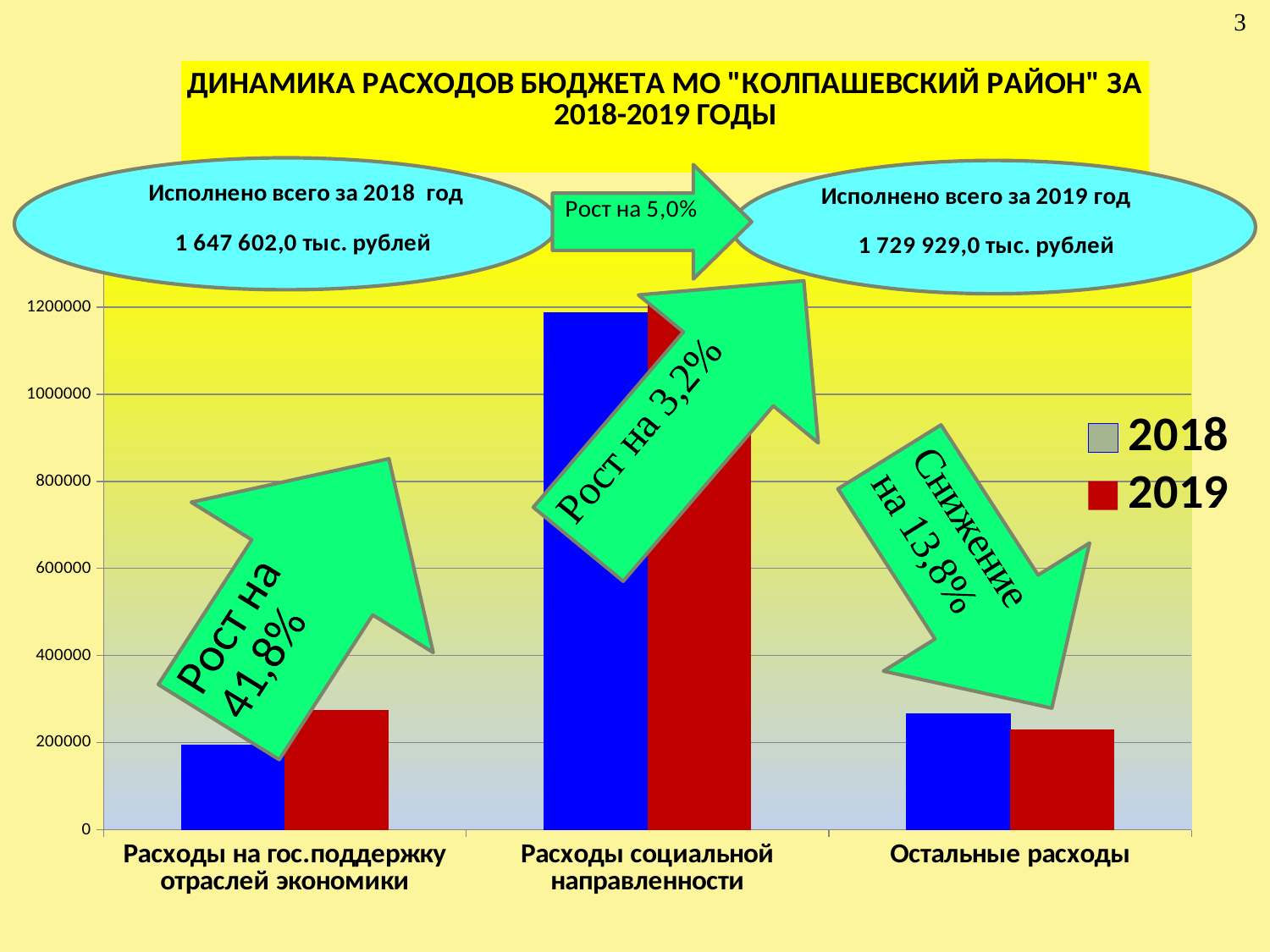
How many series does the legend list? 2 How many categories are shown on the x axis? 3 Is the 2019 value for Расходы на гос.поддержку отраслей экономики greater or less than 200000? greater Which colour represents the 2019 series in the legend? red According to the arrow annotation, by what percentage did Остальные расходы change? Снижение на 13,8% For Расходы на гос.поддержку отраслей экономики, which year has the larger value, 2018 or 2019? 2019 Which category has the highest values for both years? Расходы социальной направленности For Остальные расходы, which year has the larger value, 2018 or 2019? 2018 Is the 2019 value for Остальные расходы greater or less than 400000? less What kind of chart is shown on the slide? bar chart Is the 2018 value for Расходы социальной направленности greater or less than 1000000? greater Which category has the lowest 2018 value? Расходы на гос.поддержку отраслей экономики